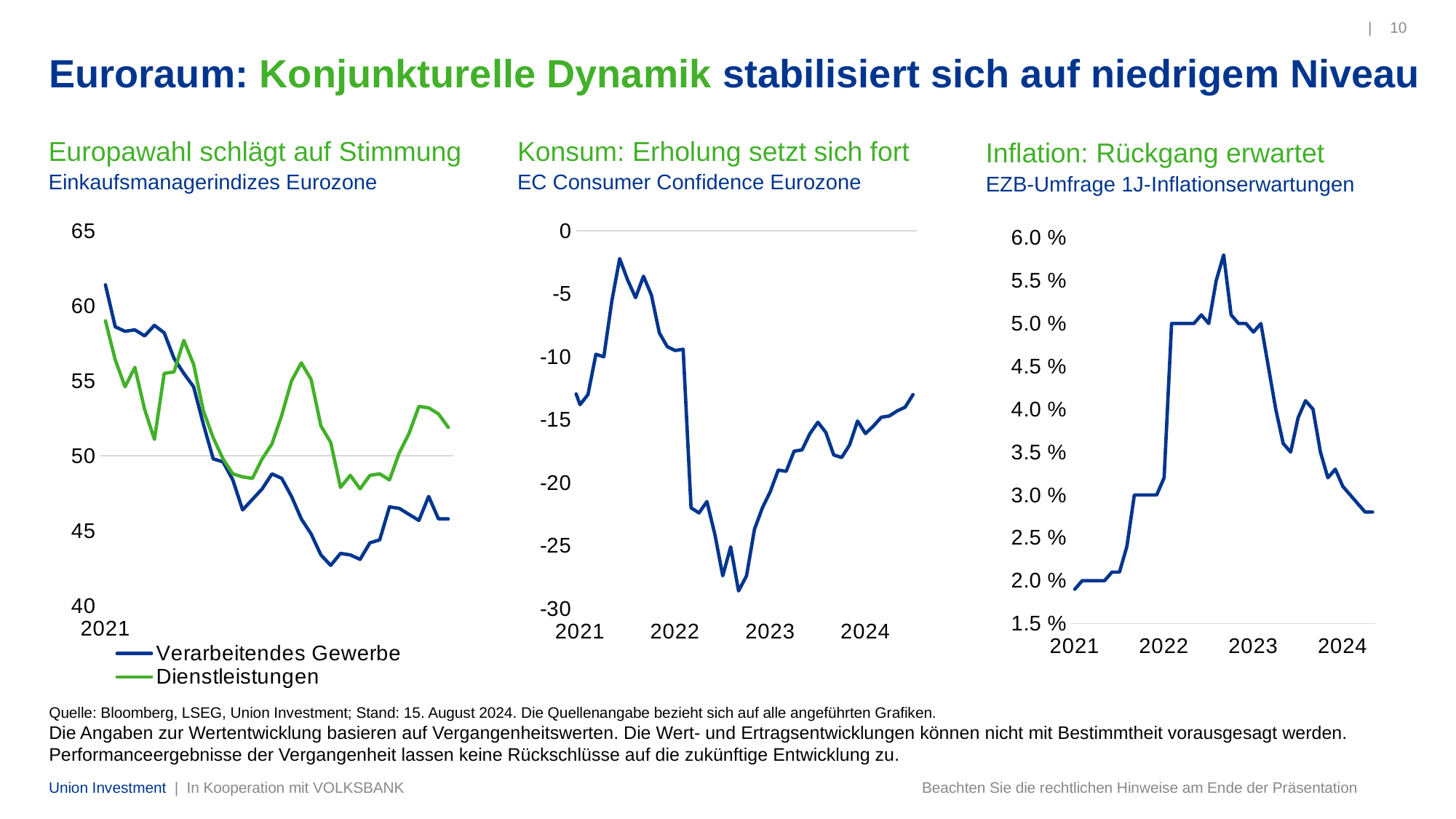
In the chart titled "EZB-Umfrage 1J-Inflationserwartungen", is the highest point of the line greater or less than 5.5 %? greater In the chart titled "EC Consumer Confidence Eurozone", is the lowest point of the line greater or less than -25? less How many series does the legend of the chart titled "Einkaufsmanagerindizes Eurozone" list? 2 In the chart titled "Einkaufsmanagerindizes Eurozone", does the Verarbeitendes Gewerbe line overall rise or fall from 2021 to 2024? fall What kind of chart is the chart titled "Einkaufsmanagerindizes Eurozone"? line chart In the chart titled "Einkaufsmanagerindizes Eurozone", is the latest value for Verarbeitendes Gewerbe greater or less than 50? less What kind of chart is the chart titled "EC Consumer Confidence Eurozone"? line chart In the chart titled "Einkaufsmanagerindizes Eurozone", which series is drawn in green? Dienstleistungen In the chart titled "EC Consumer Confidence Eurozone", does the line rise or fall from 2023 to 2024? rise In the chart titled "EZB-Umfrage 1J-Inflationserwartungen", does the line rise or fall from 2023 to 2024? fall What is the green headline above the chart titled "EZB-Umfrage 1J-Inflationserwartungen"? Inflation: Rückgang erwartet